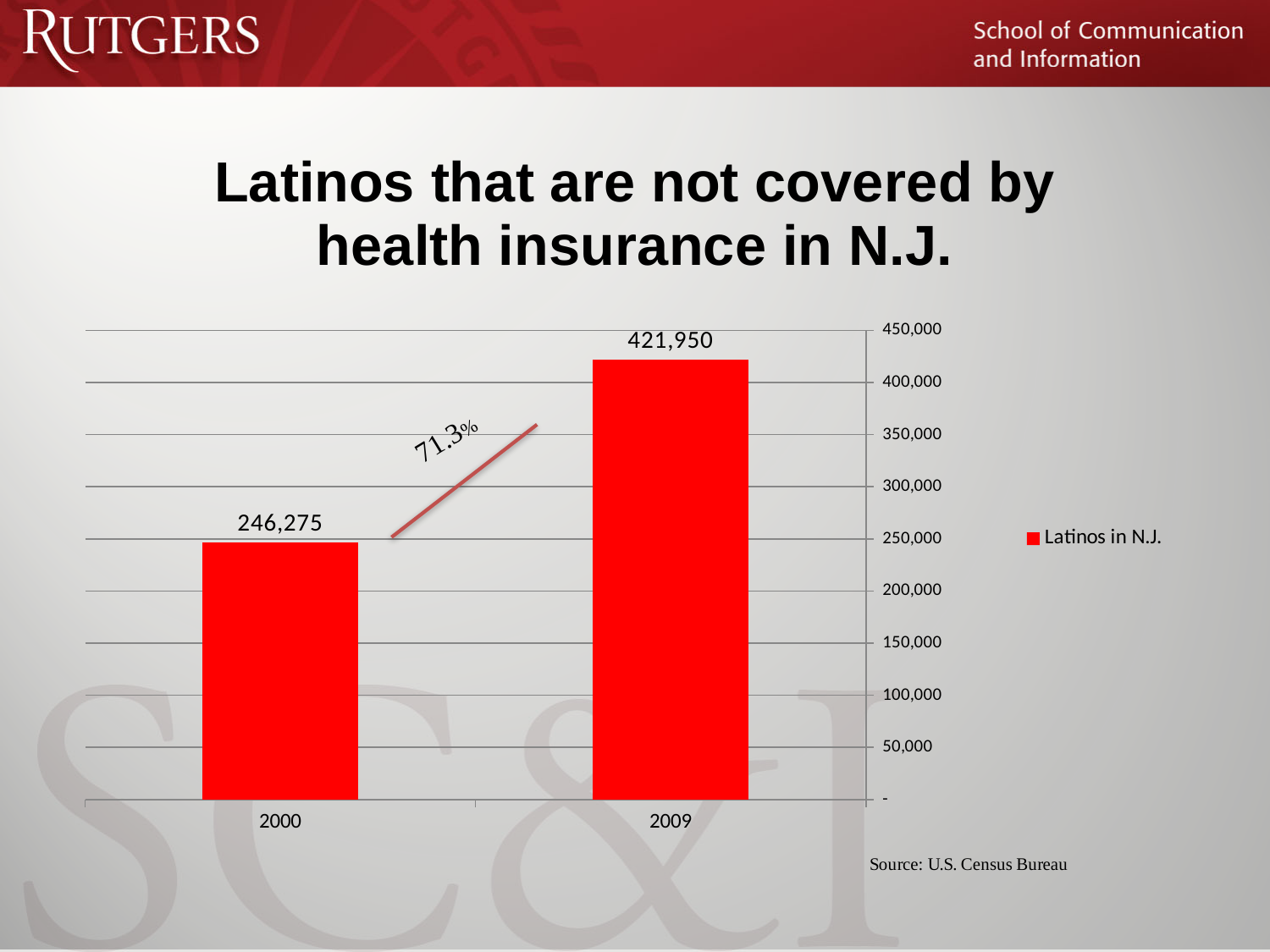
How many series does the legend list? 1 What percentage change is annotated between the two bars? 71.3% Do the values rise or fall from 2000 to 2009? rise What is the difference between the 2009 value and the 2000 value? 175,675 Is the value for 2009 greater or less than 400,000? greater What is the value for 2000? 246,275 What kind of chart is shown? bar chart How many years are shown on the x axis? 2 Which year has the higher value? 2009 Which year has the lower value? 2000 What is the value for 2009? 421,950 Is the value for 2000 greater or less than 250,000? less